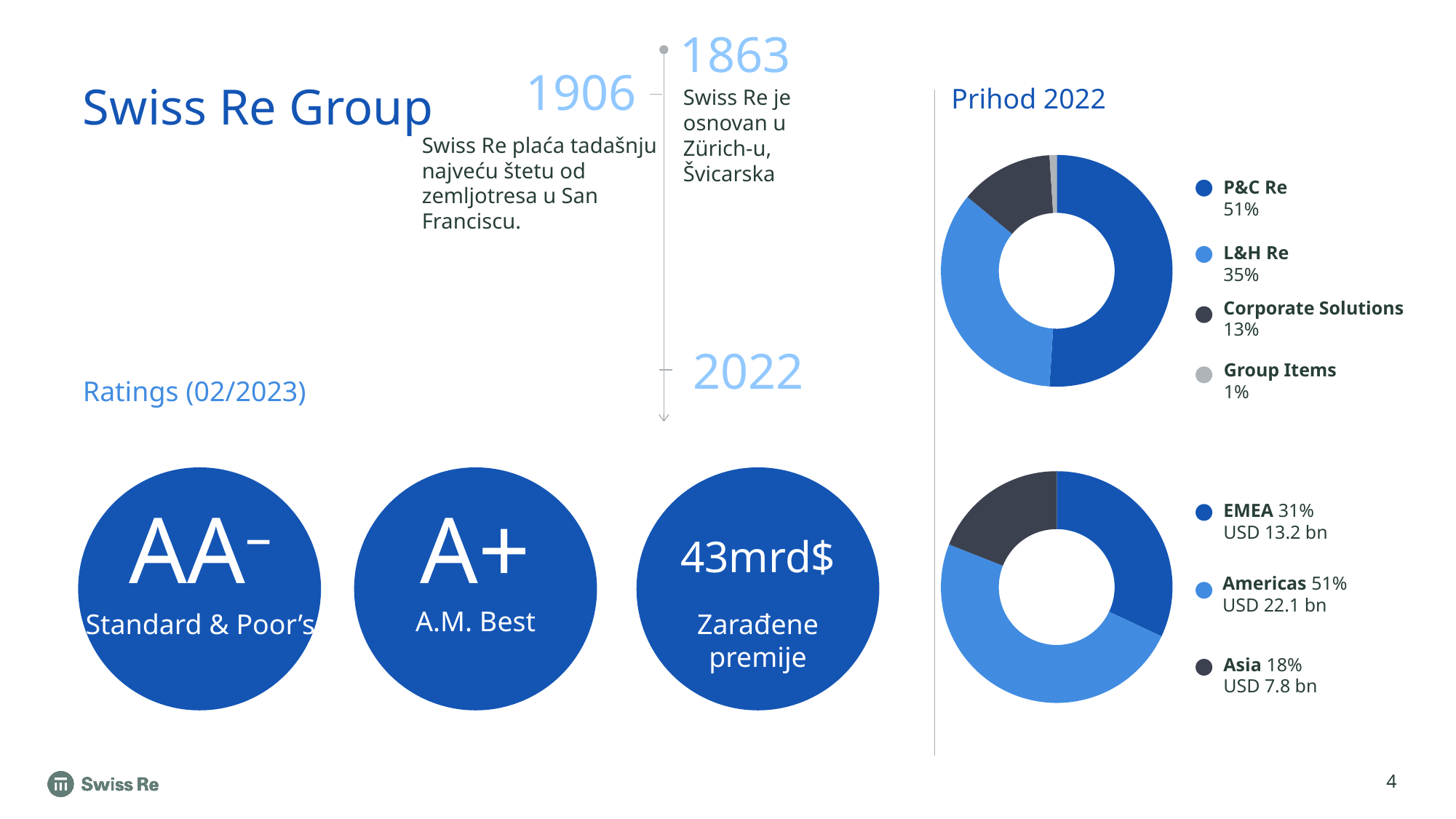
How many segments does the legend of the top donut chart (Prihod 2022) list? 4 In the top donut chart (Prihod 2022), which segment has the largest share? P&C Re What type of chart is used for the top chart titled Prihod 2022? Donut (pie) chart In the top donut chart (Prihod 2022), what share does Corporate Solutions have? 13% In the top donut chart (Prihod 2022), which segment has the smallest share? Group Items In the top donut chart (Prihod 2022), what share does P&C Re have? 51% In the bottom donut chart, what share does Asia have? 18% In the bottom donut chart, which is larger, EMEA or Asia? EMEA In the bottom donut chart, what is the value in USD for Americas? USD 22.1 bn In the bottom donut chart, what is the difference in USD bn between Americas and EMEA? USD 8.9 bn In the top donut chart (Prihod 2022), how many percentage points larger is P&C Re than L&H Re? 16 In the bottom donut chart, which region has the largest share? Americas